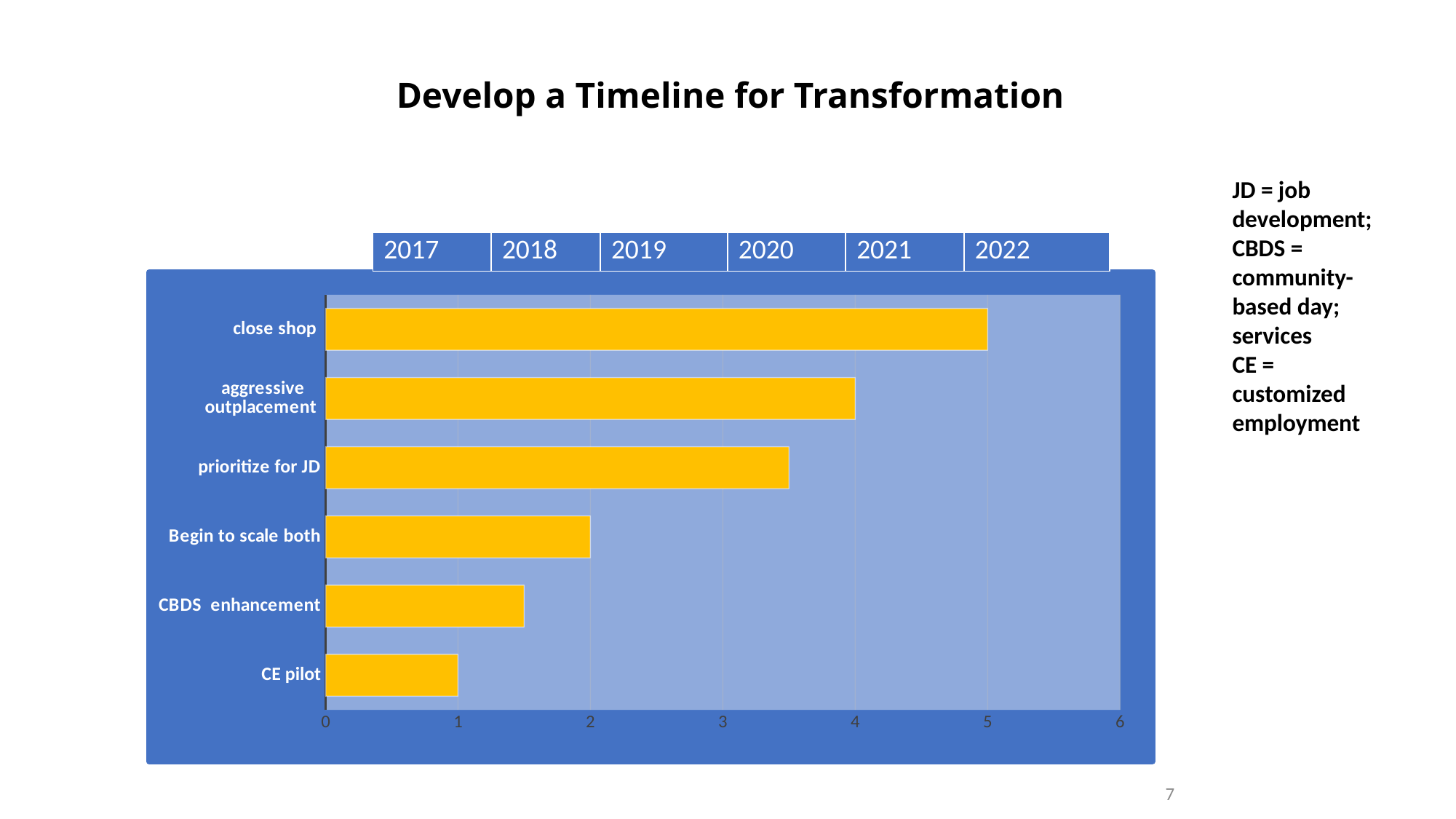
Is the value for prioritize for JD greater or less than 3? greater What is the value for CE pilot? 1 What is the title of the slide containing the chart? Develop a Timeline for Transformation What is the value for close shop? 5 What type of chart is shown on the slide? bar chart What is the value for Begin to scale both? 2 Which category has the shortest bar? CE pilot Is the value for CBDS enhancement greater or less than 2? less How many categories are plotted in the chart? 6 What is the value for aggressive outplacement? 4 Which category has the longest bar? close shop What is the difference between the values for close shop and CE pilot? 4